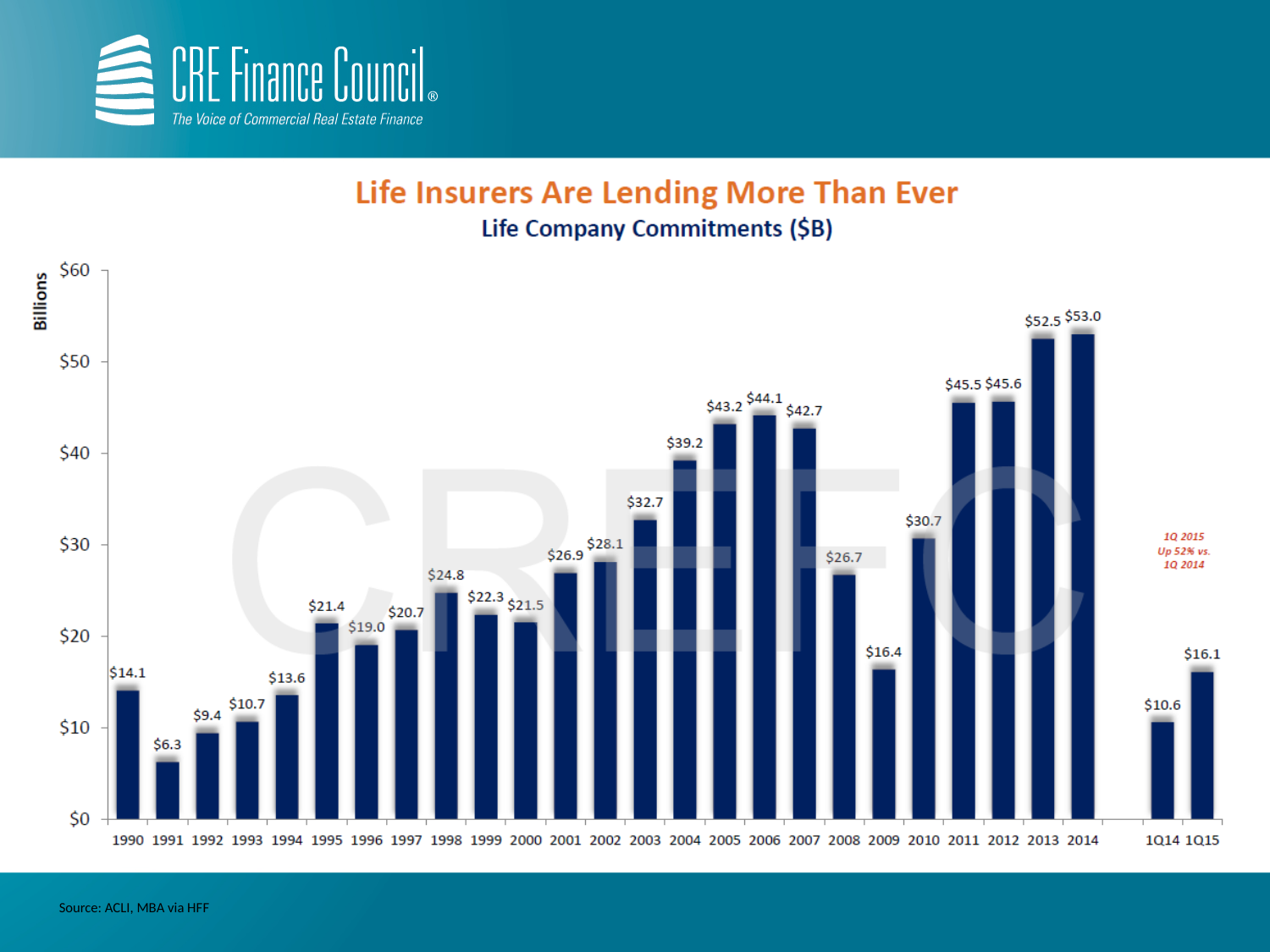
Do the values rise or fall from 2009 to 2014? rise Which year has the lowest value? 1991 What is the value for 1Q15? $16.1 What is the value for 1991? $6.3 Which is larger, the value for 2008 or the value for 2010? 2010 What is the value for 2014? $53.0 Is the value for 2006 greater or less than $40? greater What is the difference between the values for 1Q15 and 1Q14? $5.5 What is the title of the chart? Life Company Commitments ($B) Which year has the highest value? 2014 What is the difference between the values for 2014 and 2013? $0.5 What kind of chart is this? bar chart